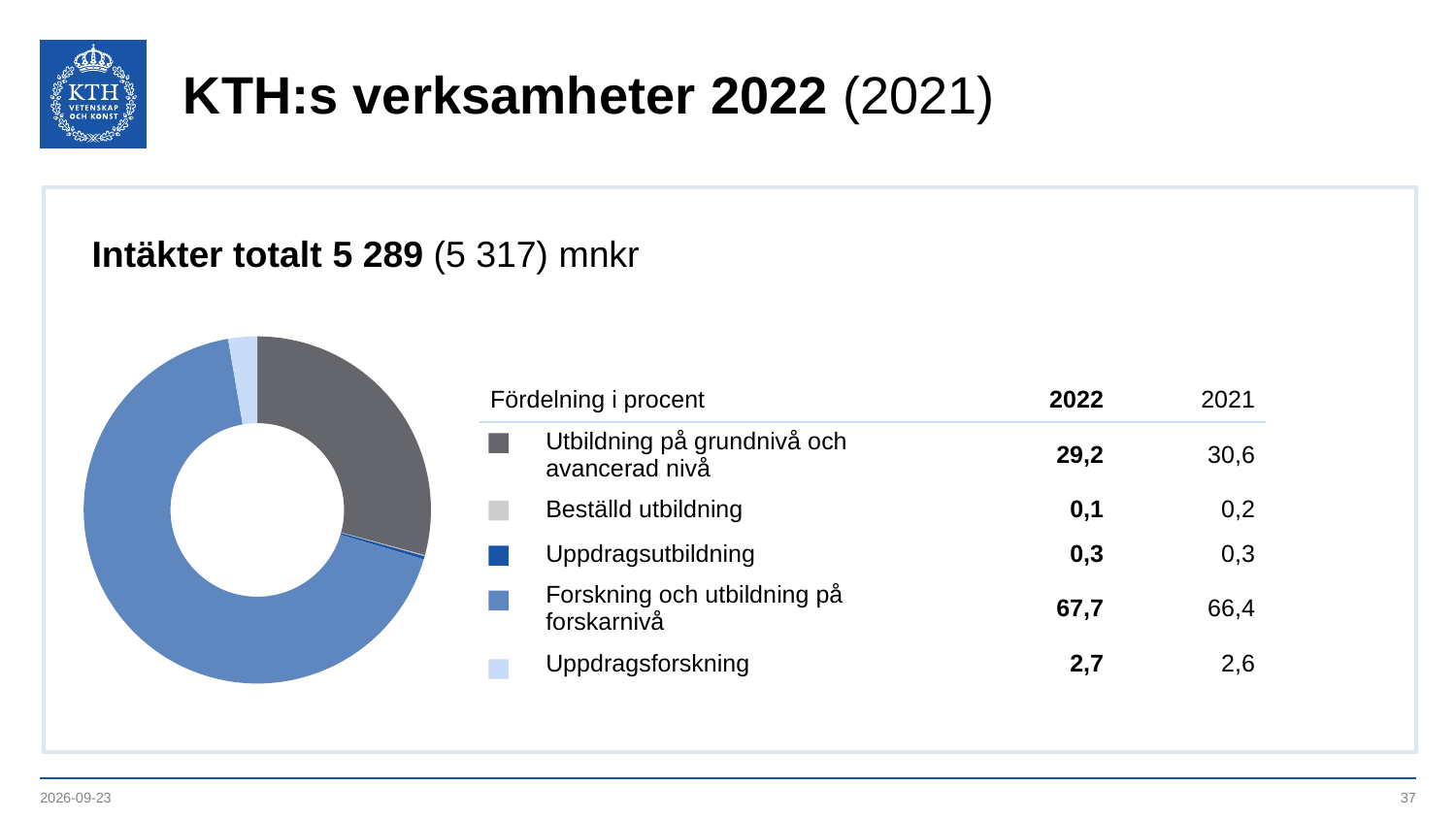
Which category has the largest share in 2022? Forskning och utbildning på forskarnivå What is the 2022 percentage for Utbildning på grundnivå och avancerad nivå? 29,2 What kind of chart is shown on the slide? Doughnut chart What is the total income (Intäkter totalt) for 2022 in mnkr? 5 289 Which category has the smallest share in 2022? Beställd utbildning How many categories are listed in the table next to the doughnut chart? 5 What is the 2021 percentage for Uppdragsforskning? 2,6 What is the 2022 percentage for Forskning och utbildning på forskarnivå? 67,7 Which is larger in 2022: Uppdragsforskning or Uppdragsutbildning? Uppdragsforskning What is the difference between the 2022 and 2021 percentages for Forskning och utbildning på forskarnivå? 1,3 What is the 2021 percentage for Beställd utbildning? 0,2 What is the heading of the table next to the chart? Fördelning i procent